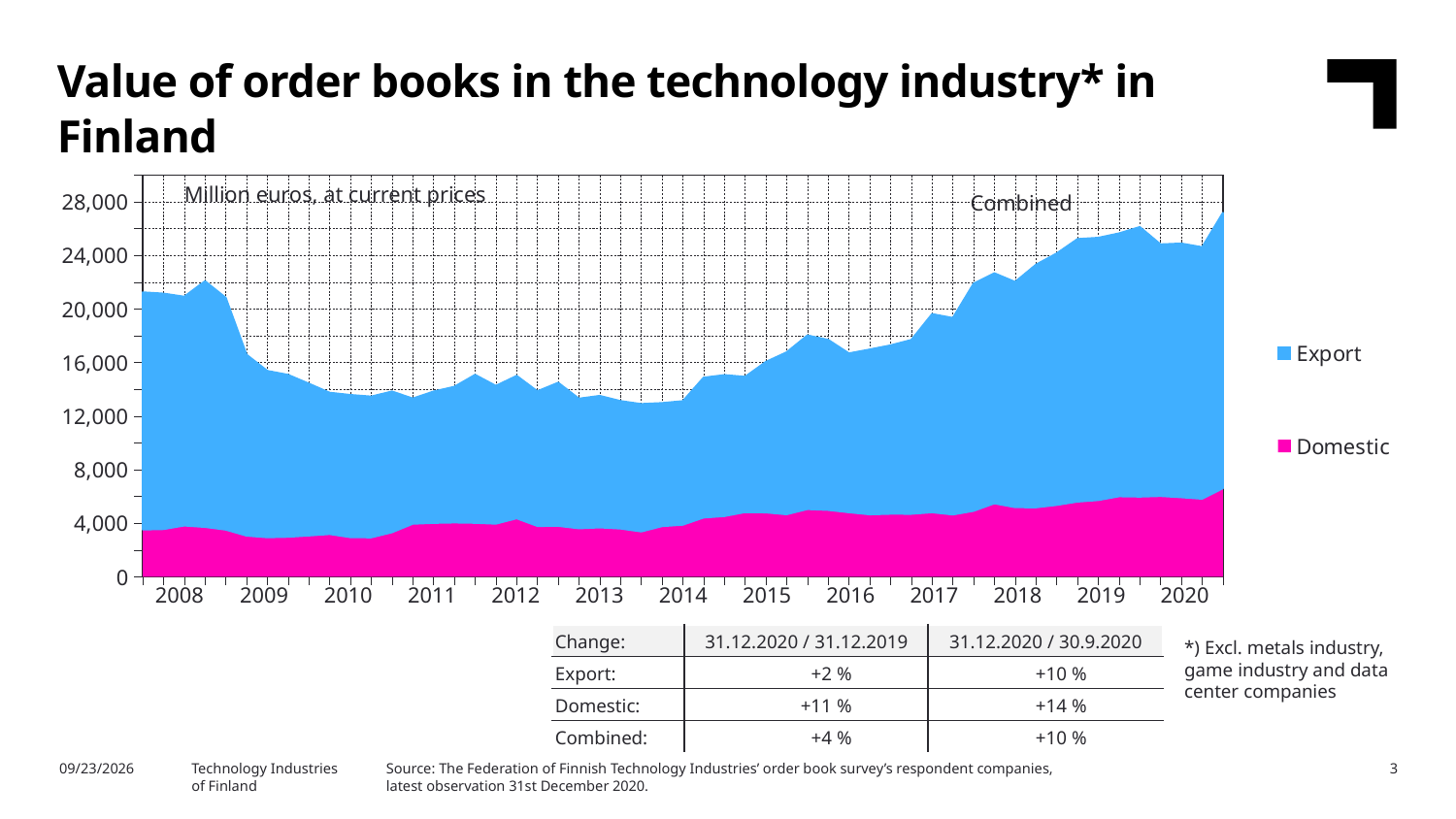
What kind of chart is shown on the slide? Area chart How many year labels appear on the x axis of the chart? 13 Which series is larger throughout the chart, Export or Domestic? Export Which two series are listed in the chart legend? Export and Domestic Does the combined value rise or fall between 2013 and 2020? rise Is the combined value at the start of 2008 greater or less than 24,000? less Does the combined value rise or fall between 2008 and 2010? fall Is the combined value during 2013 greater or less than 16,000? less How many series does the chart legend list? 2 What unit is stated for the values in the chart? Million euros, at current prices Is the combined value at the end of 2020 greater or less than 24,000? greater